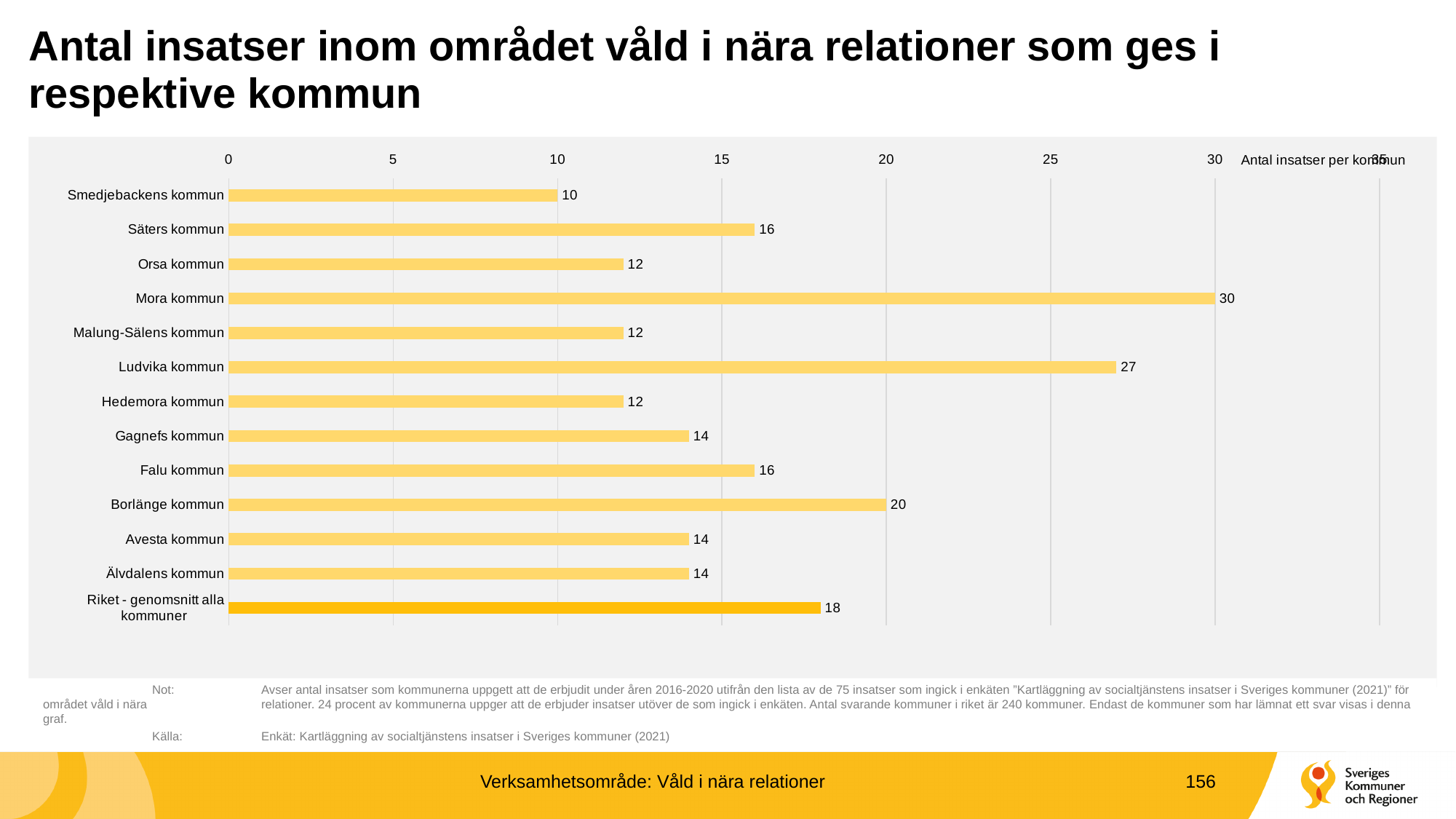
What is the difference between the values for Borlänge kommun and Smedjebackens kommun? 10 Which category has the lowest value? Smedjebackens kommun Which category has the highest value? Mora kommun How many categories are shown in the chart? 13 What is the difference between the values for Mora kommun and Ludvika kommun? 3 What is the value for Borlänge kommun? 20 What is the value for Riket - genomsnitt alla kommuner? 18 What kind of chart is shown on the slide? bar chart Which is larger, the value for Säters kommun or the value for Gagnefs kommun? Säters kommun Is the value for Ludvika kommun greater or less than 25? greater What is the label of the value axis? Antal insatser per kommun What is the value for Mora kommun? 30